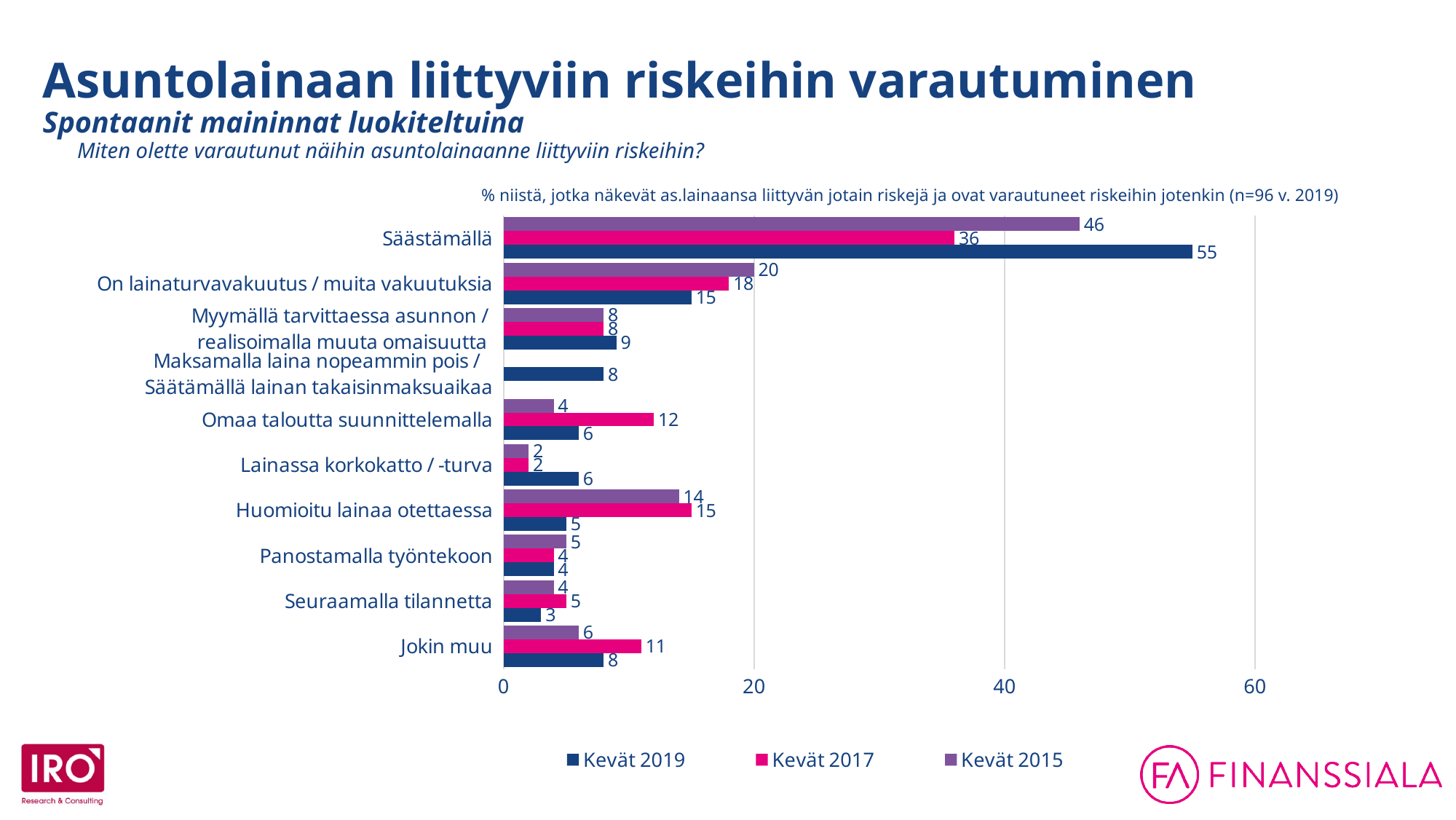
For Omaa taloutta suunnittelemalla, which is larger: the Kevät 2017 value or the Kevät 2019 value? Kevät 2017 How many categories are shown on the chart? 10 What is the value for Säästämällä in the Kevät 2019 series? 55 Is the Kevät 2015 value for Säästämällä greater or less than 40? greater What is the value for Säästämällä in the Kevät 2017 series? 36 Which series is shown in pink in the legend? Kevät 2017 What kind of chart is shown on the slide? Bar chart How many series does the legend list? 3 What is the value for Jokin muu in the Kevät 2017 series? 11 What is the value for On lainaturvavakuutus / muita vakuutuksia in the Kevät 2015 series? 20 Which category has the highest value in the Kevät 2019 series? Säästämällä What is the difference between the Kevät 2019 and Kevät 2017 values for Säästämällä? 19